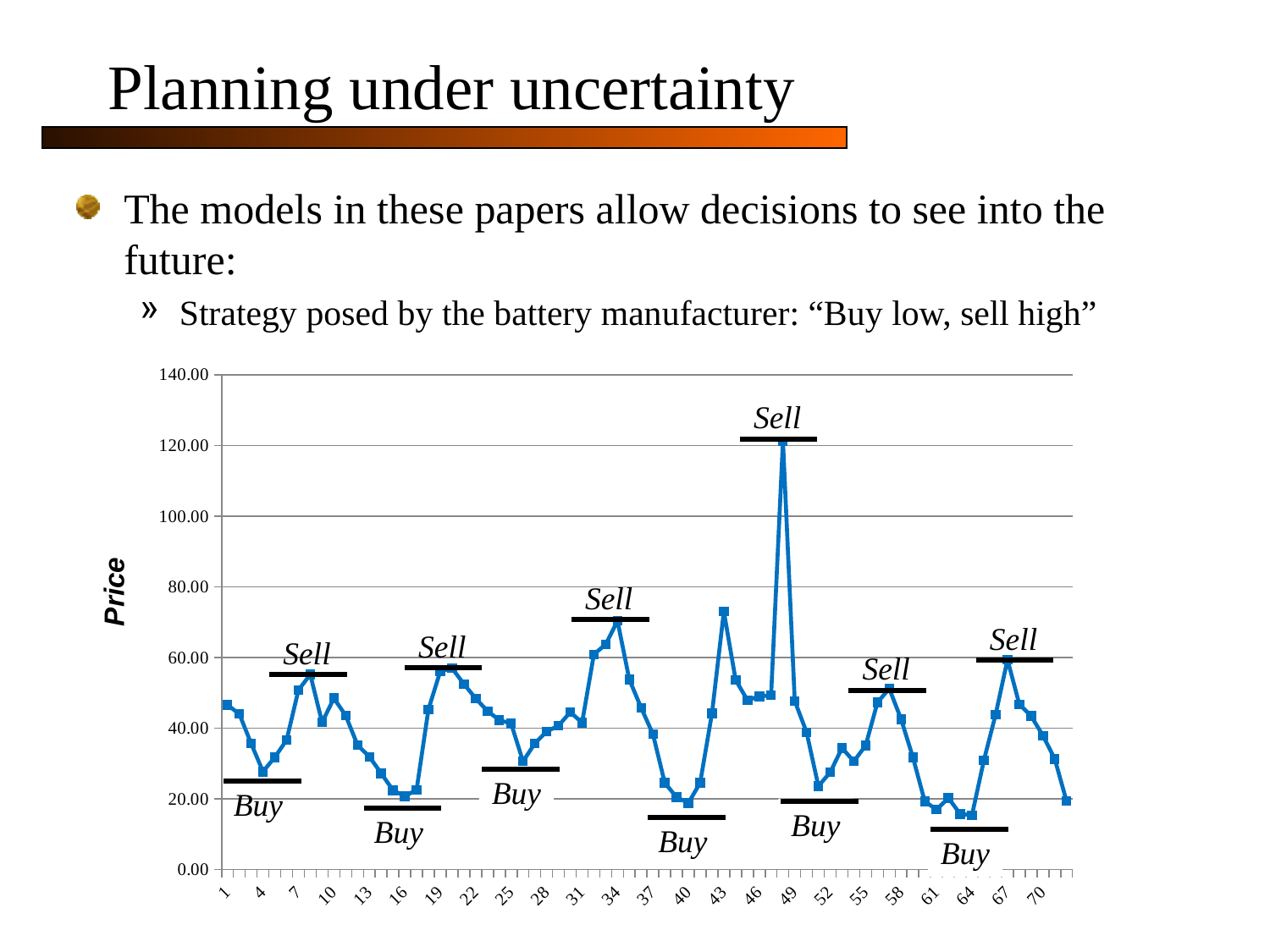
What is the highest value shown on the vertical axis of the chart? 140.00 Is the price at point 64 greater or less than 20? less What is the title of the vertical axis of the chart? Price Is the price at point 34 greater or less than 60? greater What kind of chart is shown on the slide? line chart Does the price rise or fall from point 31 to point 34? rise Is the price at point 1 greater or less than 40? greater Does the price rise or fall from point 1 to point 4? fall